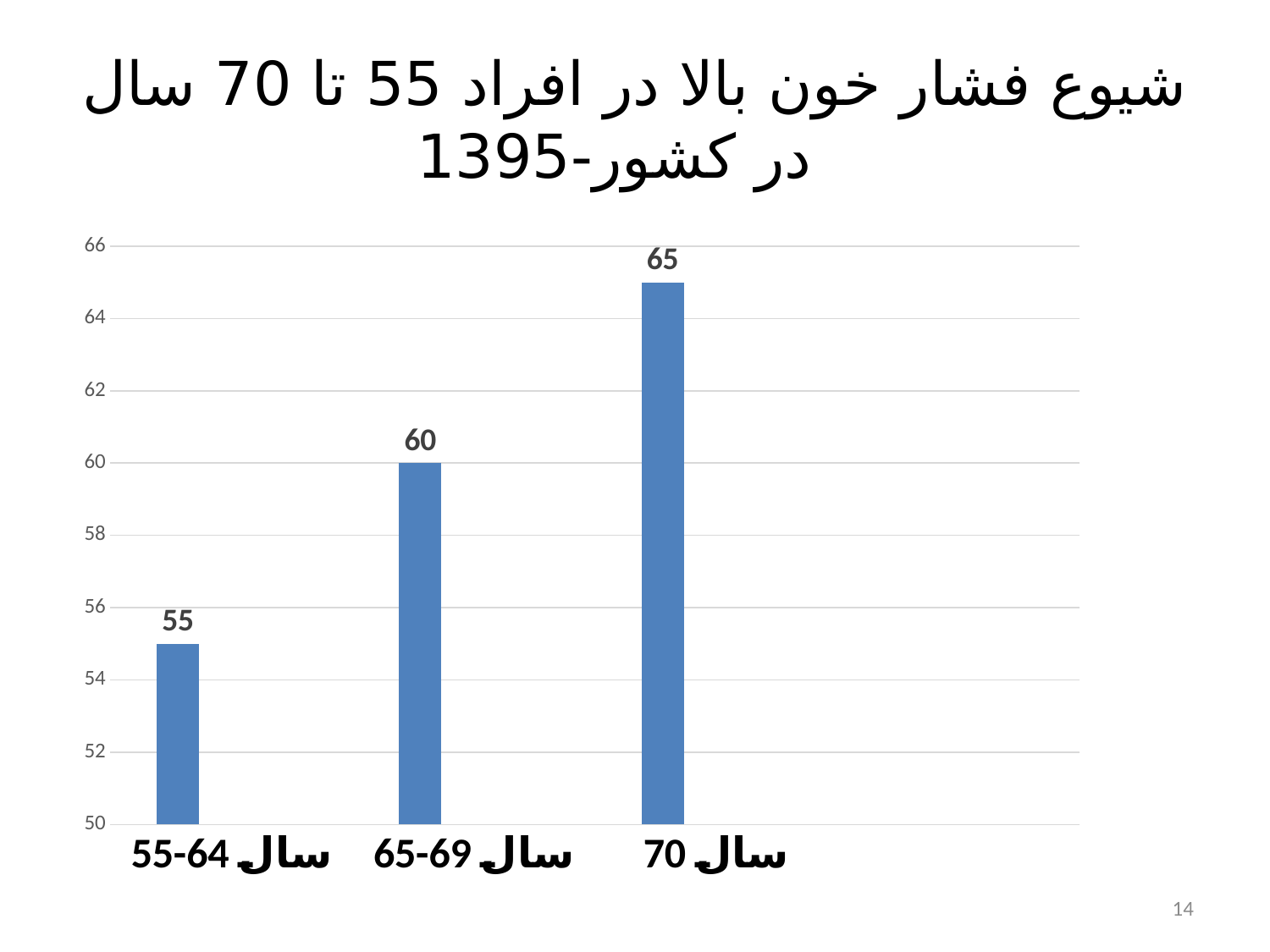
What kind of chart is shown on the slide? bar chart What is the value for the 55-64 سال category? 55 How many categories are shown in the chart? 3 Which is larger, the value for 65-69 سال or the value for 55-64 سال? 65-69 سال Is the value for 70 سال greater or less than 62? greater Which category has the highest value? 70 سال What is the difference between the values for 70 سال and 55-64 سال? 10 Which category has the lowest value? 55-64 سال What is the value for the 70 سال category? 65 Do the values rise or fall from left to right along the x axis? rise What is the value for the 65-69 سال category? 60 What is the difference between the values for 65-69 سال and 55-64 سال? 5